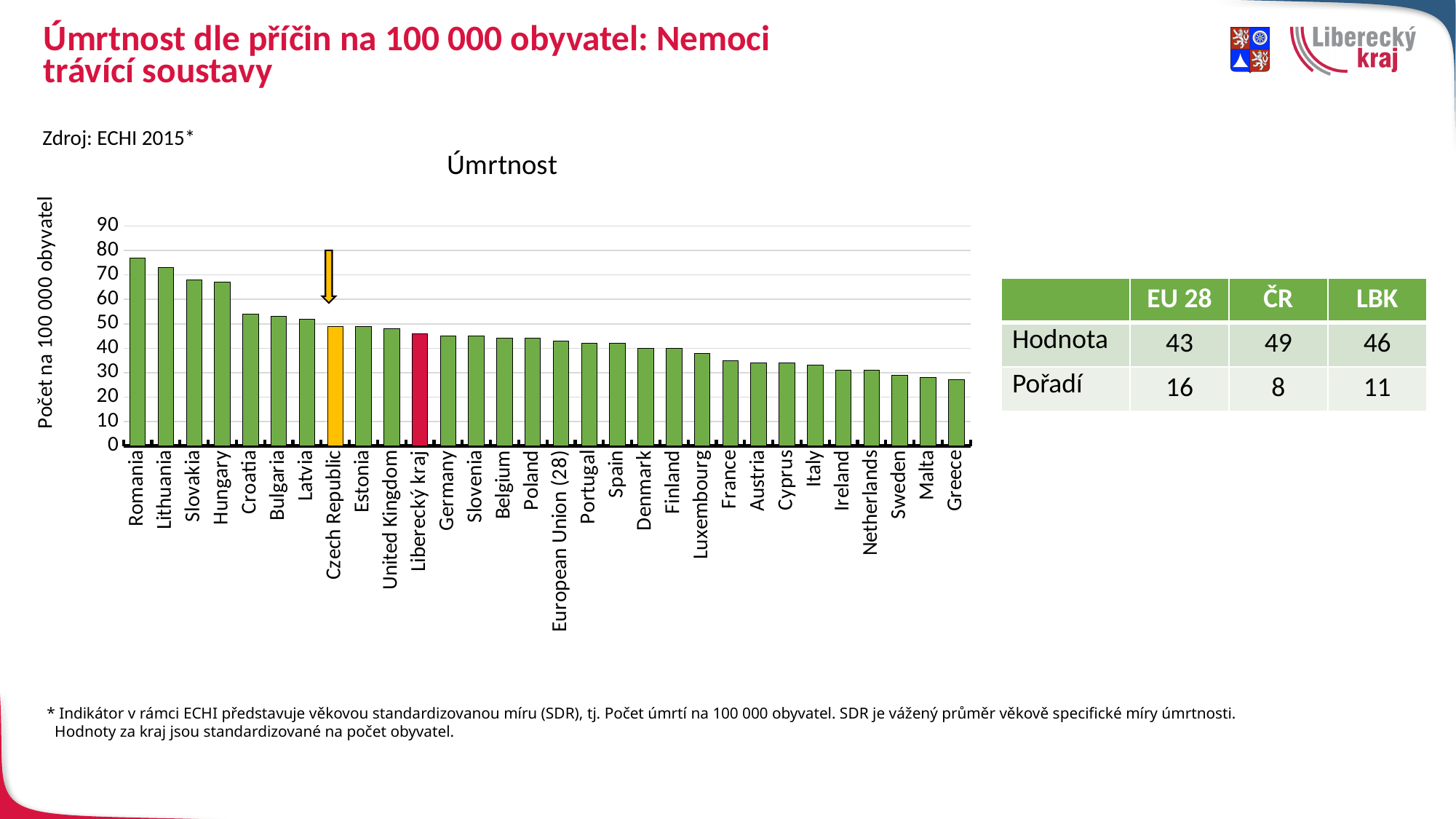
Which category has the highest value in the chart? Romania Is the value for Greece greater or less than 30? less Which has a larger value, Romania or Lithuania? Romania What type of chart is shown on the slide? bar chart Do the values rise or fall from left to right along the x axis? fall According to the table on the slide, what is the value (Hodnota) for LBK? 46 How many categories (bars) are plotted in the chart? 30 What is the label of the vertical axis of the chart? Počet na 100 000 obyvatel According to the table on the slide, what is the value (Hodnota) for ČR? 49 What is the title of the chart? Úmrtnost Is the value for Luxembourg greater or less than 40? less Is the value for Romania greater or less than 70? greater